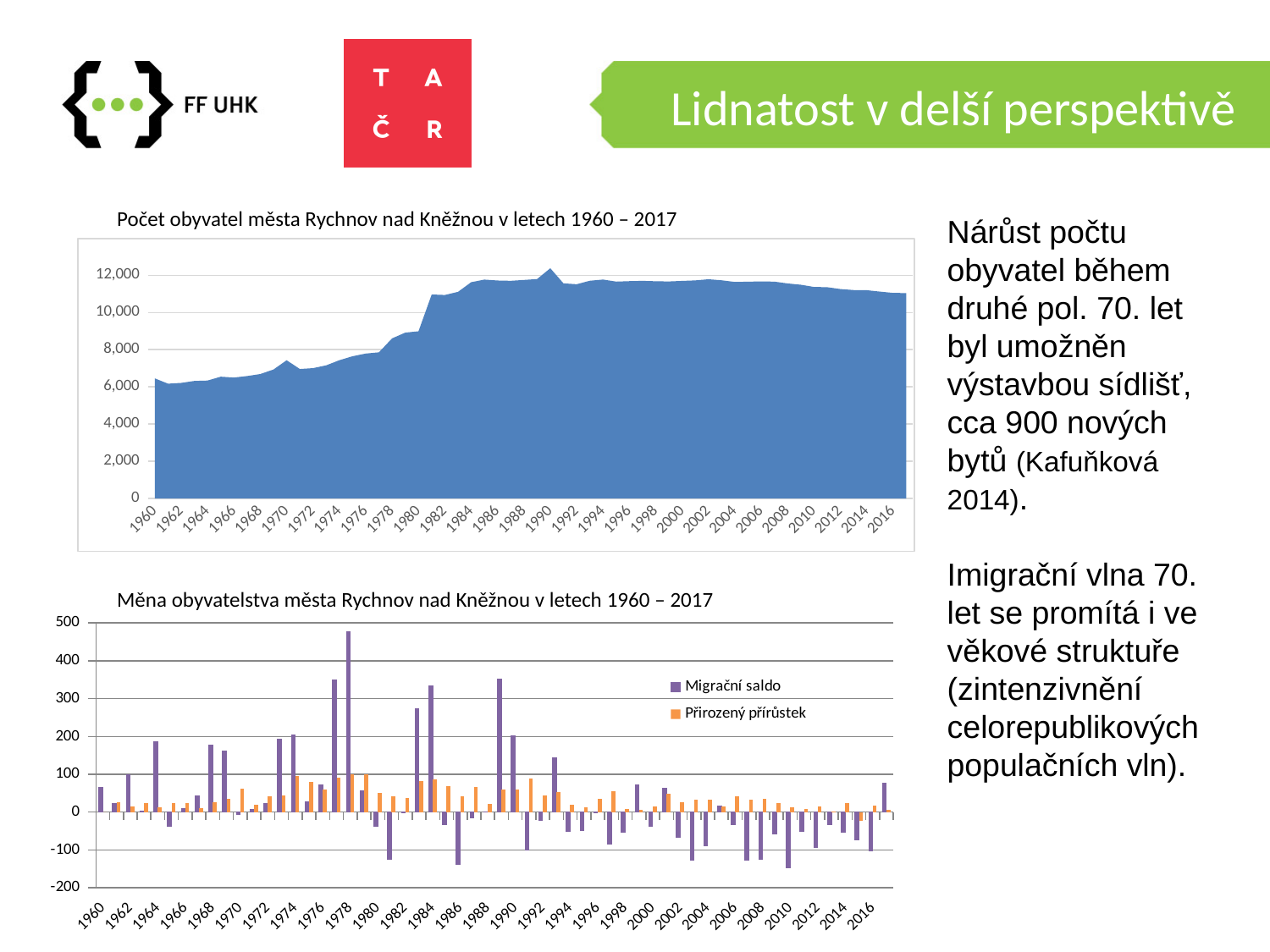
In the bottom chart 'Měna obyvatelstva', which series is shown in orange? Přirozený přírůstek In the top chart 'Počet obyvatel', in which year does the population reach its highest value? 1990 In the top chart 'Počet obyvatel', is the value for 1980 greater or less than 8,000? greater In the top chart 'Počet obyvatel', is the value for 1960 greater or less than 6,000? greater In the top chart 'Počet obyvatel', is the value for 2016 greater or less than 12,000? less In the top chart 'Počet obyvatel', does the population generally rise or fall between 1960 and 1990? rise What type of chart is the bottom chart, 'Měna obyvatelstva města Rychnov nad Kněžnou v letech 1960 – 2017'? bar chart In the bottom chart 'Měna obyvatelstva', how many series does the legend list? 2 In the bottom chart 'Měna obyvatelstva', which is larger, the Migrační saldo for 1978 or for 1984? 1978 What type of chart is the top chart, 'Počet obyvatel města Rychnov nad Kněžnou v letech 1960 – 2017'? area chart In the bottom chart 'Měna obyvatelstva', in which year is Migrační saldo highest? 1978